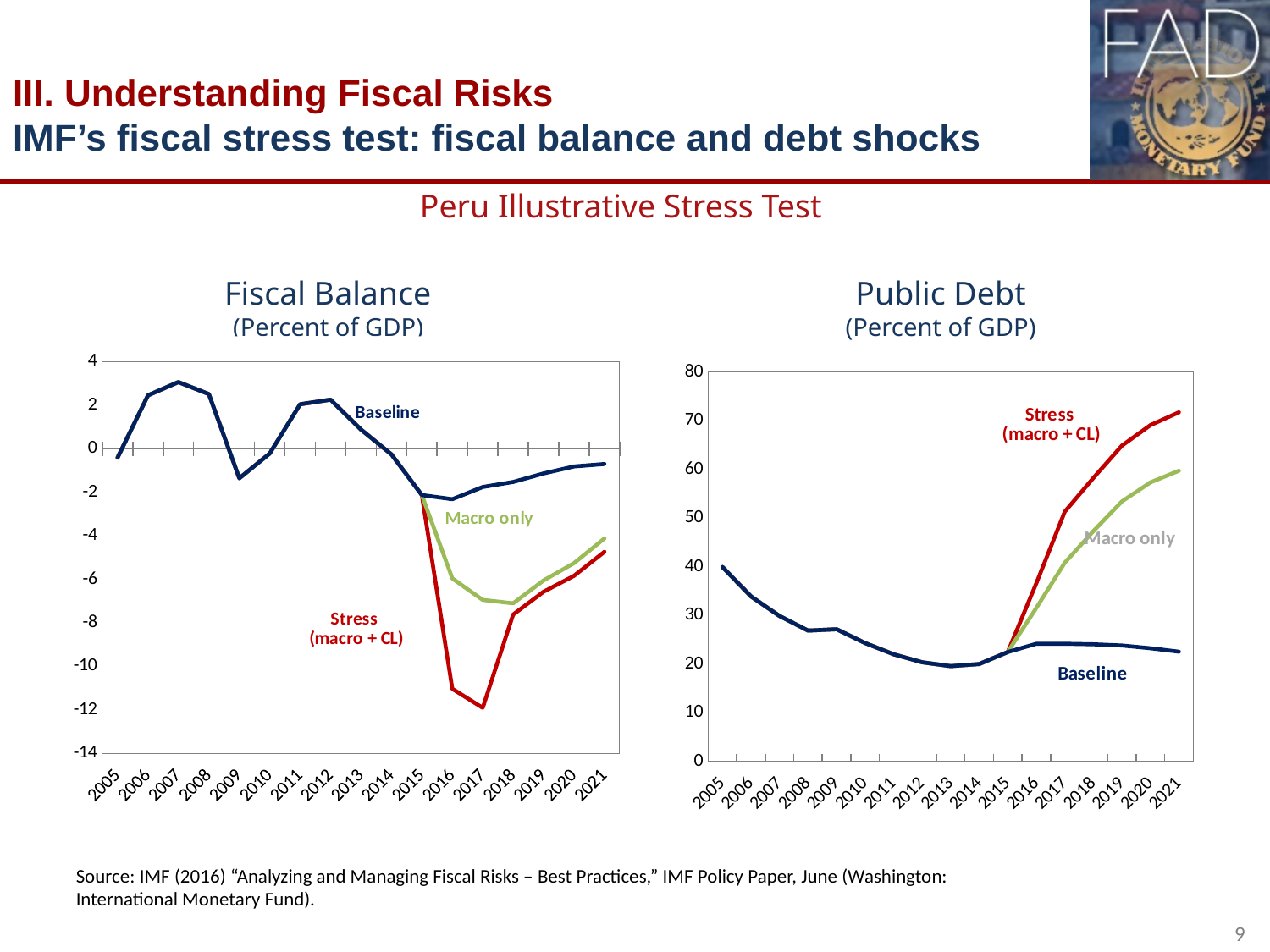
In the Public Debt chart, which line is higher in 2021, Stress (macro + CL) or Macro only? Stress (macro + CL) How many years are shown on the x axis of the Public Debt chart? 17 How many scenario lines are plotted in the Fiscal Balance chart? 3 What unit is given in the subtitle of both charts? Percent of GDP In the Fiscal Balance chart, which year has the highest value for the Baseline line? 2007 In the Public Debt chart, does the Baseline line rise or fall from 2005 to 2013? fall In the Public Debt chart, is the Stress (macro + CL) value in 2021 greater or less than 60? greater In the Public Debt chart, is the Baseline value in 2013 greater or less than 30? less In the Fiscal Balance chart, which year has the lowest value for the Stress (macro + CL) line? 2017 In the Fiscal Balance chart, is the Stress (macro + CL) value in 2017 greater or less than -10? less What type of chart is the Fiscal Balance chart on the left? line chart